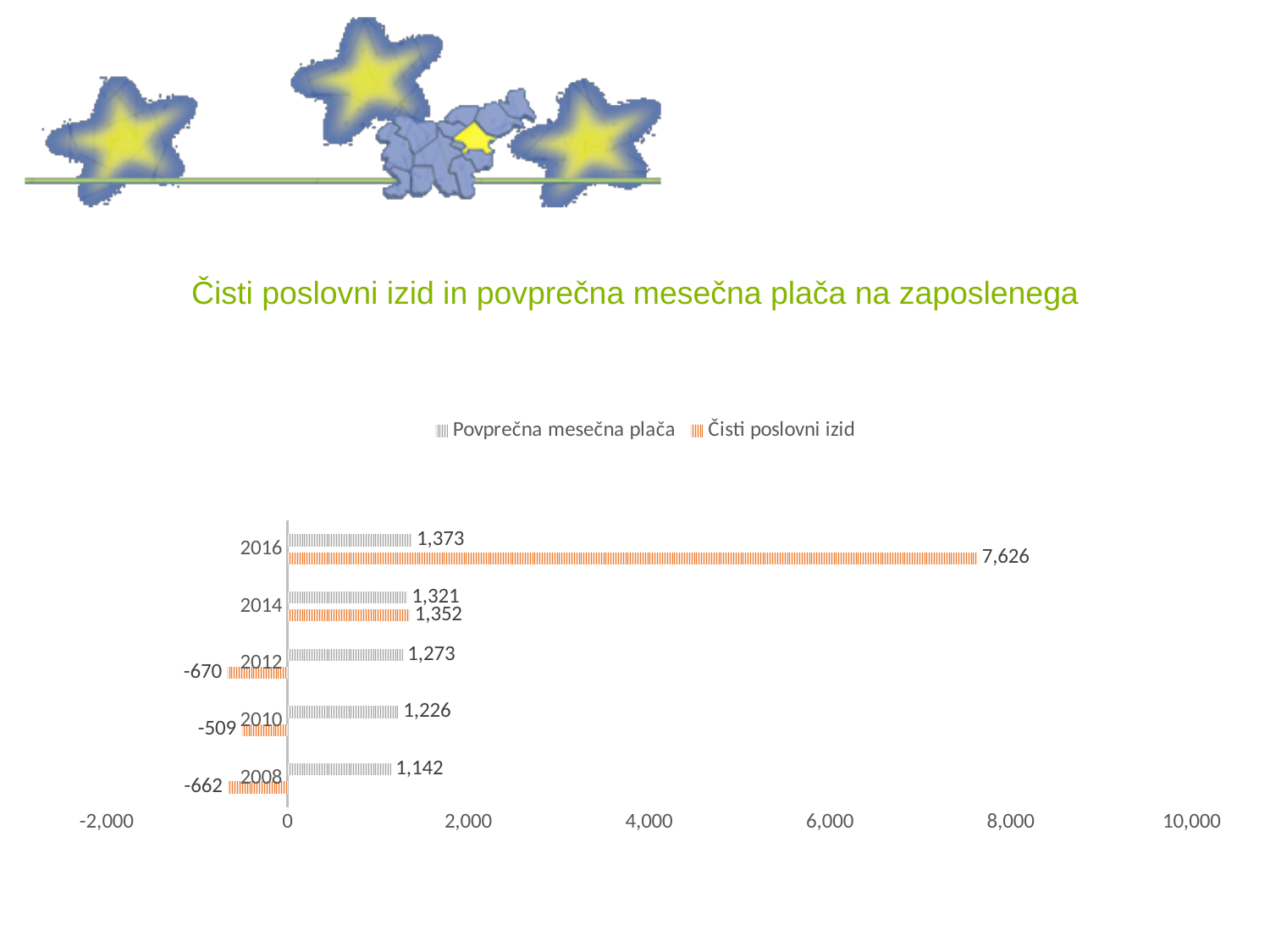
What type of chart is shown on the slide? bar chart What is the value of Povprečna mesečna plača for 2008? 1,142 Which is larger in 2010: Povprečna mesečna plača or Čisti poslovni izid? Povprečna mesečna plača What is the title of the chart? Čisti poslovni izid in povprečna mesečna plača na zaposlenega What is the value of Čisti poslovni izid for 2012? -670 Which year has the lowest Povprečna mesečna plača? 2008 Does Povprečna mesečna plača rise or fall from 2008 to 2016? rise What is the difference between Čisti poslovni izid and Povprečna mesečna plača in 2014? 31 How many series does the legend list? 2 Which year has the highest Čisti poslovni izid? 2016 What is the value of Čisti poslovni izid for 2016? 7,626 How many years are shown on the chart? 5